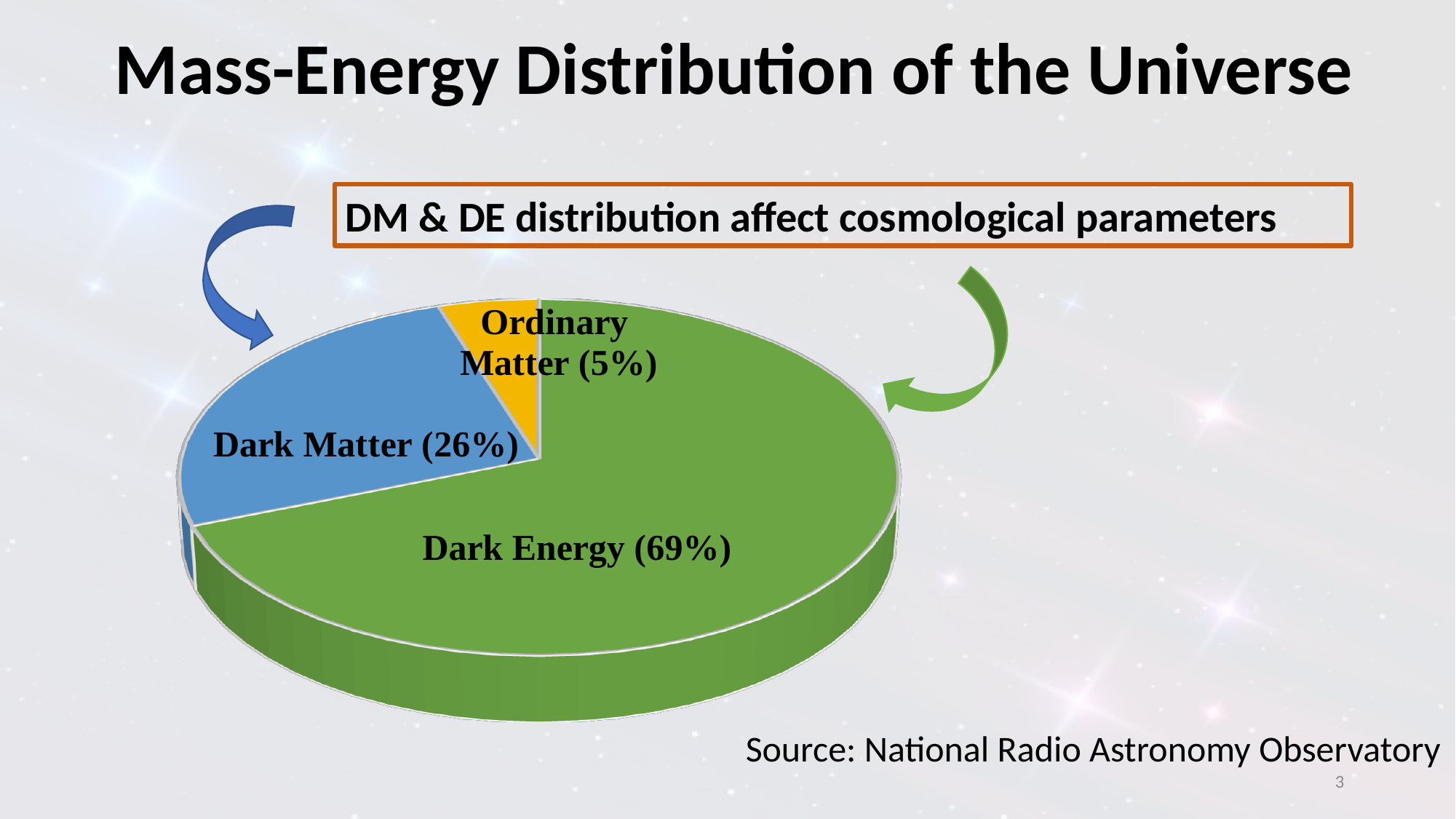
What is the difference in percentage points between Dark Energy and Dark Matter? 43 Which is larger, Dark Matter or Ordinary Matter? Dark Matter What share of the pie does Dark Energy represent? 69% What share of the pie does Ordinary Matter represent? 5% Which slice of the pie is the smallest? Ordinary Matter What share of the pie does Dark Matter represent? 26% What is the title of the slide containing the pie chart? Mass-Energy Distribution of the Universe How many slices does the pie chart have? 3 What colour is the Dark Matter slice? blue Which slice of the pie is the largest? Dark Energy What kind of chart is shown on the slide? pie chart What is the difference in percentage points between Dark Matter and Ordinary Matter? 21